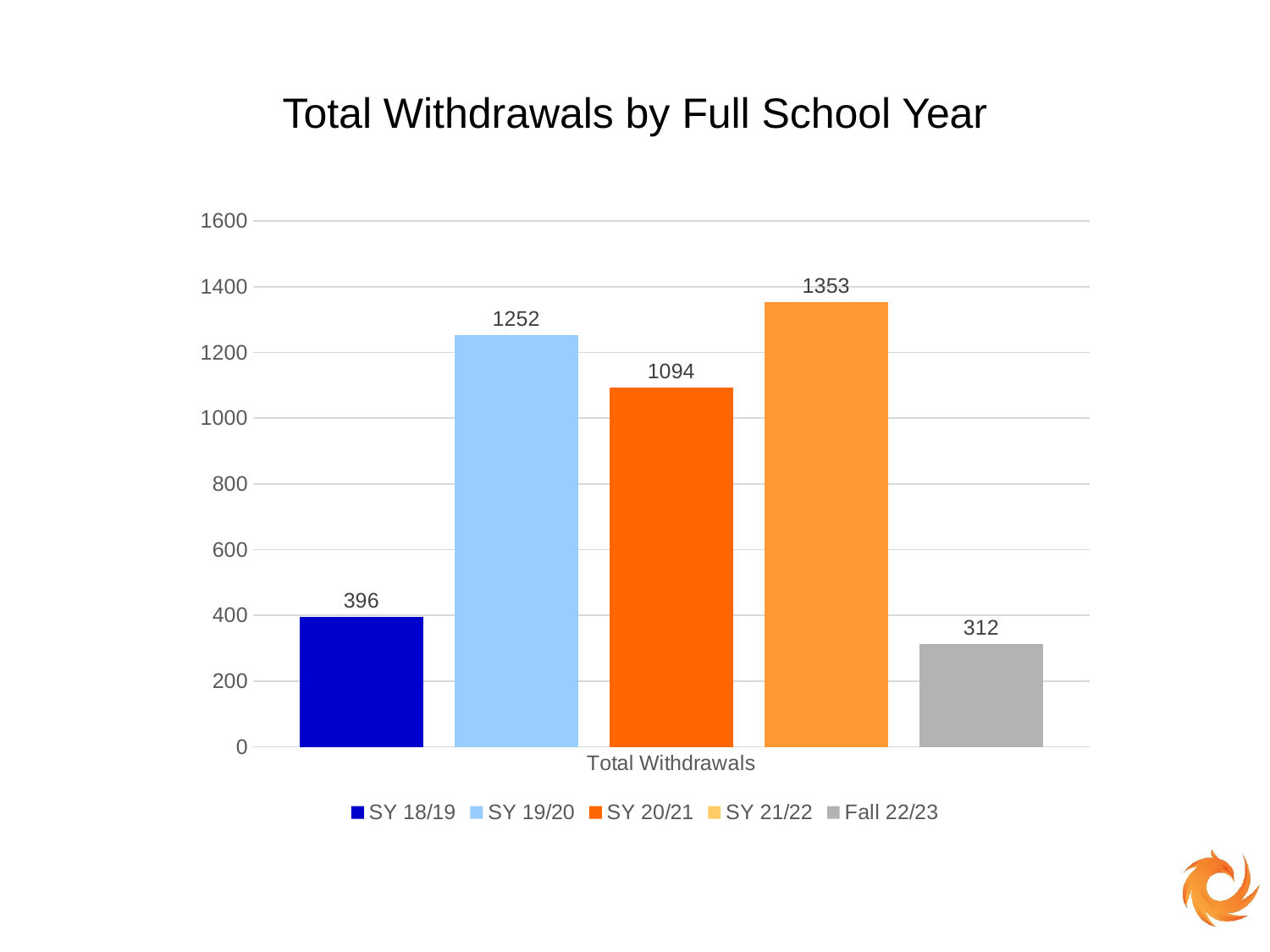
What is the difference between the values for SY 21/22 and SY 20/21? 259 Which is larger, the value for SY 19/20 or the value for SY 20/21? SY 19/20 What is the value for SY 20/21? 1094 What kind of chart is shown on the slide? Bar chart What is the value for SY 18/19? 396 What is the value for Fall 22/23? 312 Which series has the highest total withdrawals? SY 21/22 What is the value for SY 21/22? 1353 How many series does the legend list? 5 What is the value for SY 19/20? 1252 What is the title of the chart? Total Withdrawals by Full School Year Which series has the lowest total withdrawals? Fall 22/23